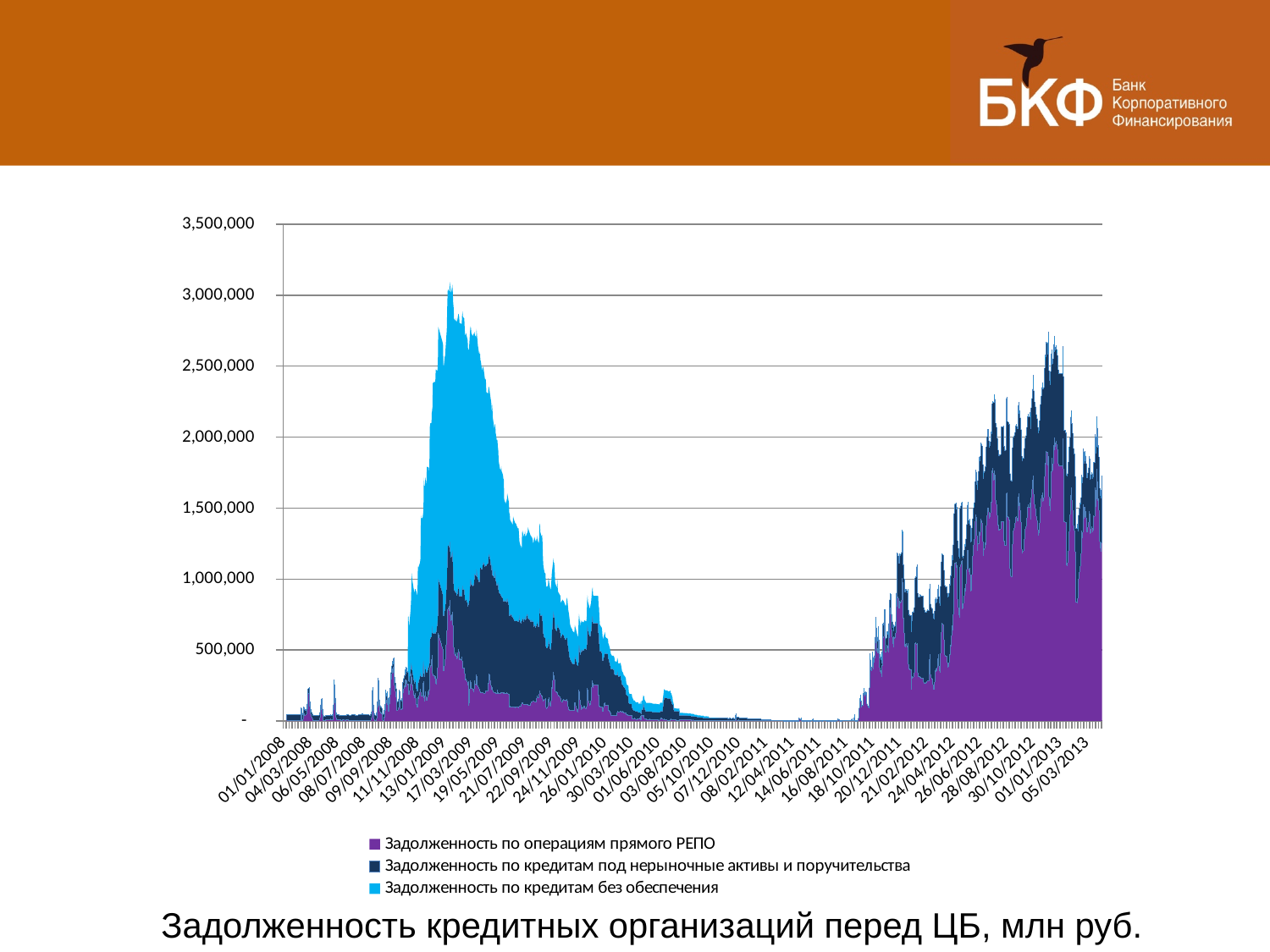
How many series does the legend list? 3 Does the total value rise or fall between 18/10/2011 and 30/10/2012? rise Is the total value around 13/01/2009 greater or less than 2,000,000? greater Which series is shown in light blue in the legend? Задолженность по кредитам без обеспечения Around 05/03/2013, which is larger: Задолженность по операциям прямого РЕПО or Задолженность по кредитам без обеспечения? Задолженность по операциям прямого РЕПО Does the total value rise or fall between 13/01/2009 and 01/06/2010? fall Which series makes up the largest part of the total around 17/03/2009? Задолженность по кредитам без обеспечения Is the total value around 07/12/2010 greater or less than 500,000? less What kind of chart is shown on the slide? Stacked area chart What is the title printed below the chart? Задолженность кредитных организаций перед ЦБ, млн руб. Is the total value around 01/01/2008 greater or less than 500,000? less